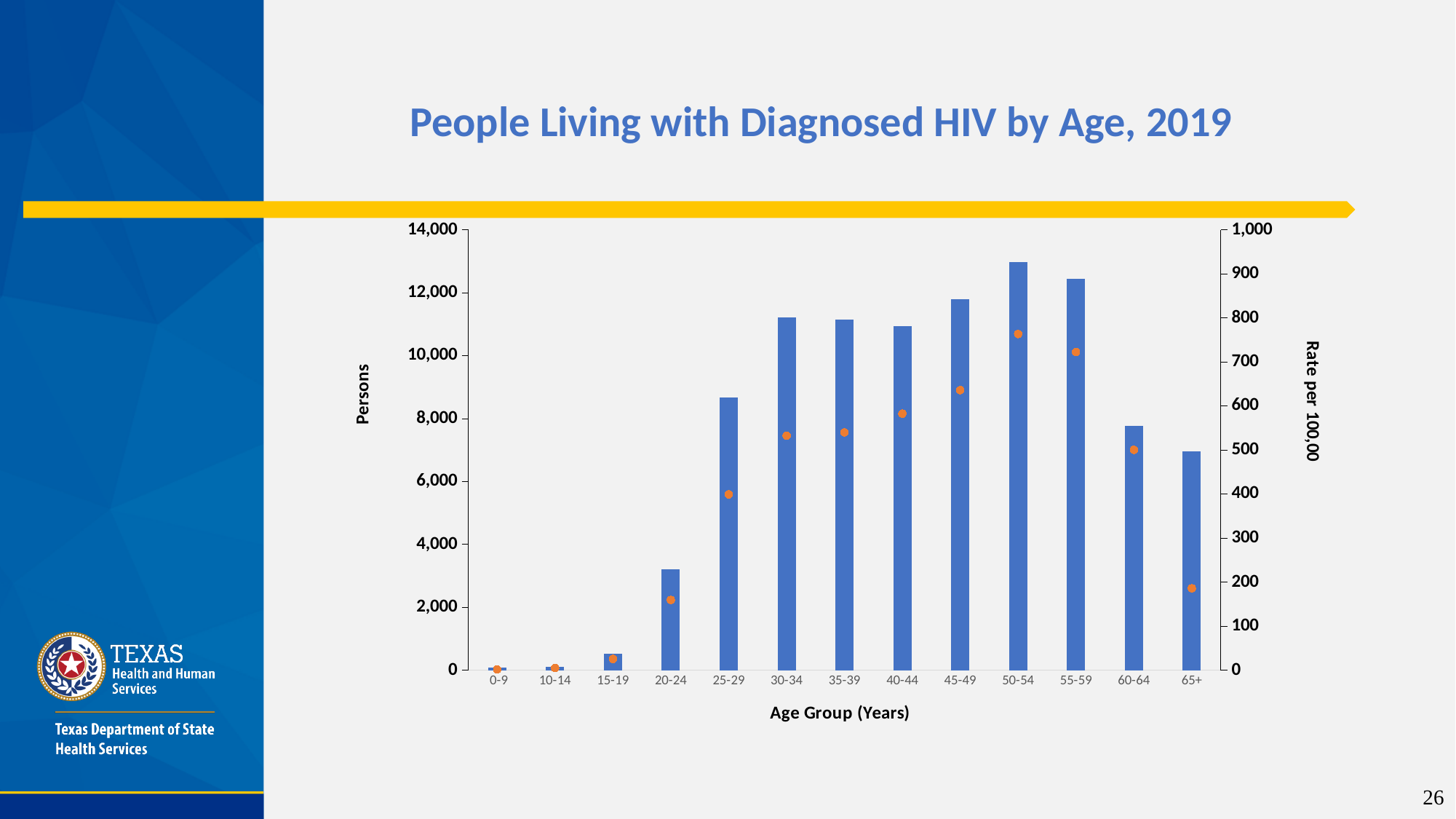
Is the rate per 100,000 for the 30-34 age group greater or less than 500? greater Is the rate per 100,000 for the 50-54 age group greater or less than 700? greater How many age groups are shown on the x axis? 13 Which age group has the highest number of persons living with diagnosed HIV? 50-54 Is the number of persons for the 20-24 age group greater or less than 2,000? greater What is the title of the x axis? Age Group (Years) Which has more persons living with diagnosed HIV, the 50-54 age group or the 55-59 age group? 50-54 What kind of chart is used to show the number of persons by age group? bar chart Do the number of persons rise or fall from the 50-54 age group to the 65+ age group? fall